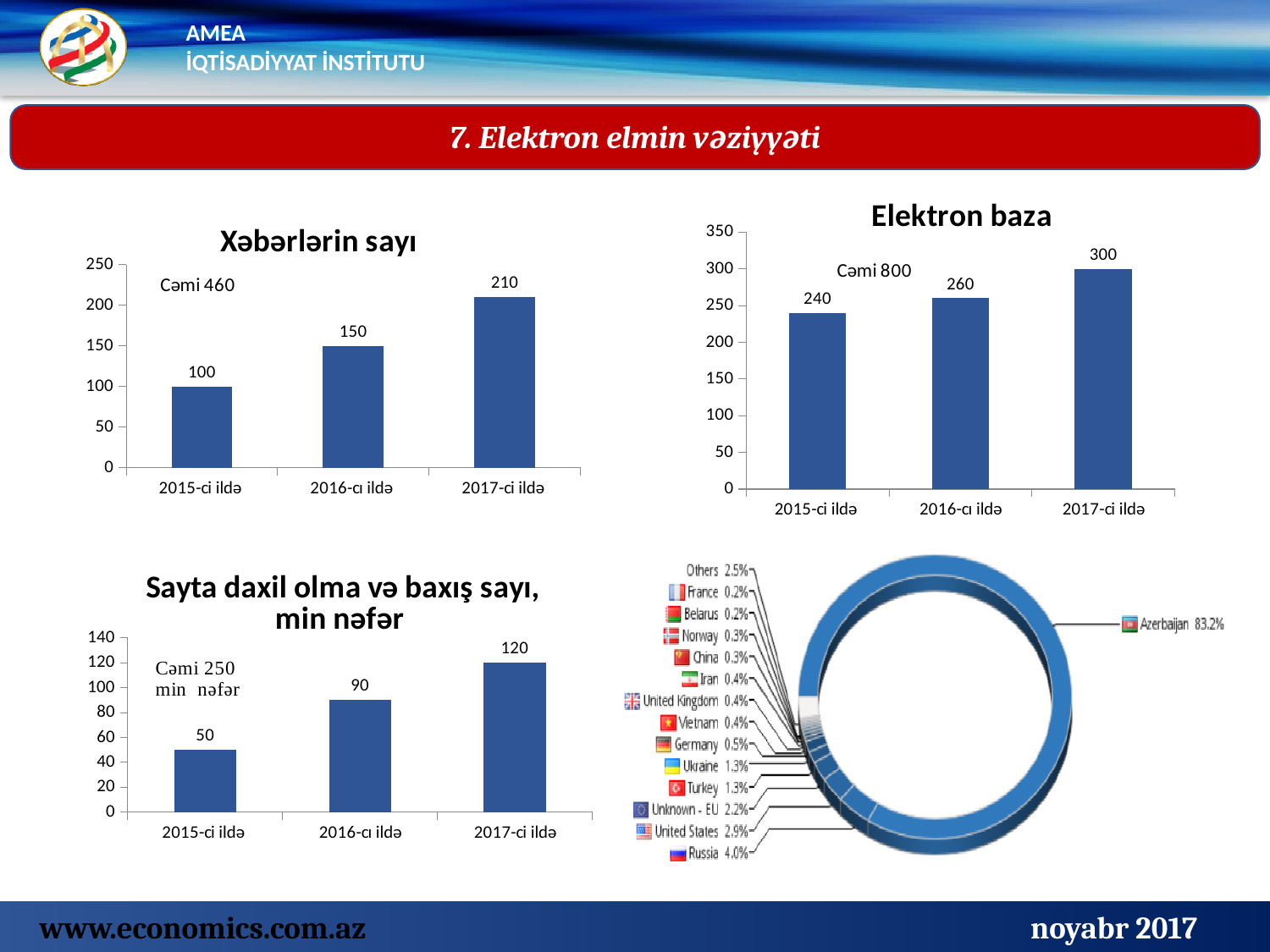
How many categories are shown in the 'Elektron baza' chart? 3 In the 'Xəbərlərin sayı' chart, do the values rise or fall from 2015-ci ildə to 2017-ci ildə? rise In the 'Xəbərlərin sayı' chart, what is the value for 2017-ci ildə? 210 In the 'Sayta daxil olma və baxış sayı, min nəfər' chart, which year has the lowest value? 2015-ci ildə In the 'Elektron baza' chart, what is the value for 2016-cı ildə? 260 In the 'Elektron baza' chart, which year has the highest value? 2017-ci ildə In the 'Elektron baza' chart, what is the difference between the values for 2017-ci ildə and 2015-ci ildə? 60 In the 'Sayta daxil olma və baxış sayı, min nəfər' chart, which is larger: the value for 2016-cı ildə or 2017-ci ildə? 2017-ci ildə In the donut chart at the bottom right, what share is shown for Azerbaijan? 83.2% What kind of chart is the 'Xəbərlərin sayı' chart? bar chart In the 'Xəbərlərin sayı' chart, what is the difference between the values for 2017-ci ildə and 2015-ci ildə? 110 In the 'Sayta daxil olma və baxış sayı, min nəfər' chart, what is the value for 2015-ci ildə? 50